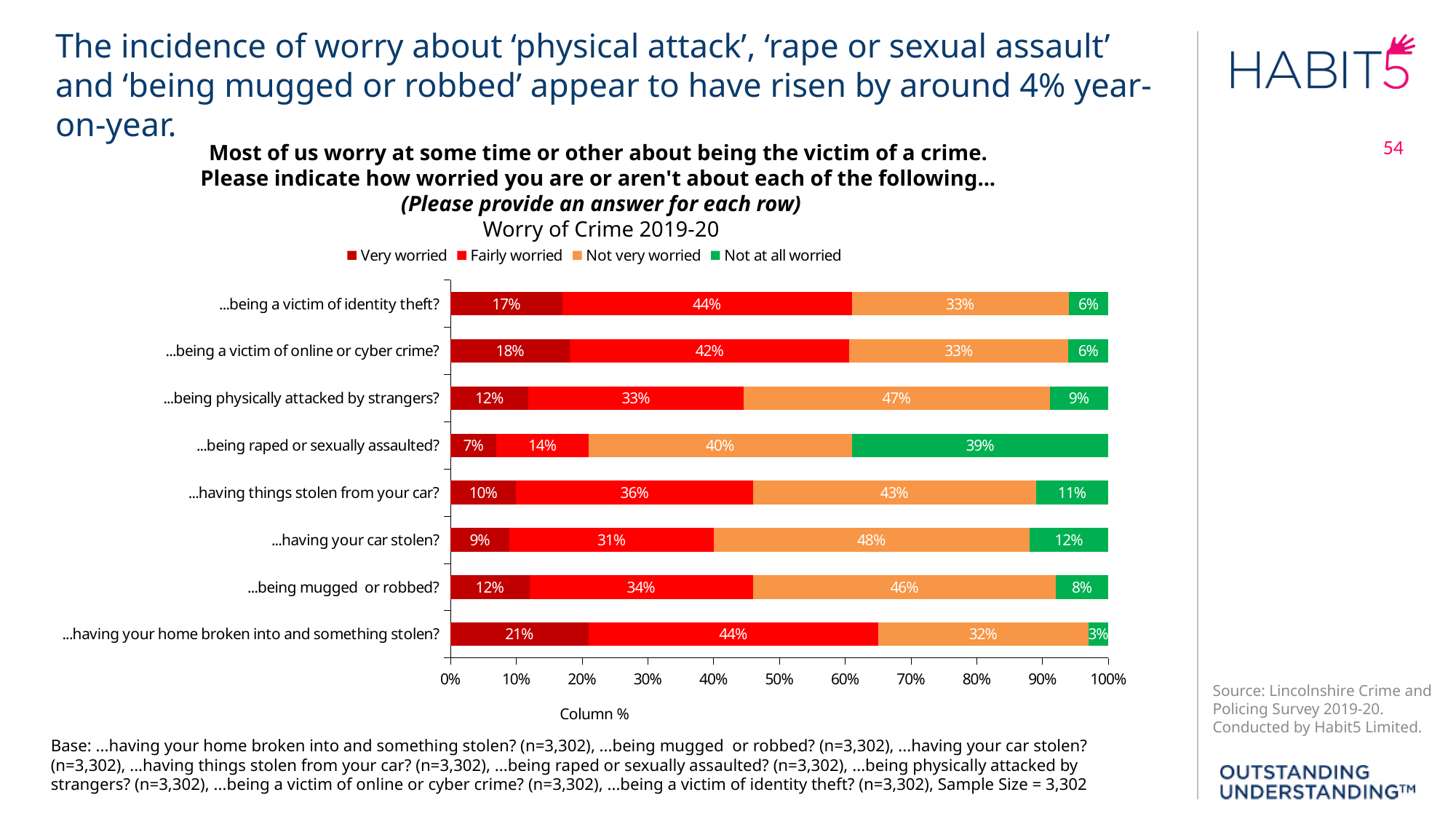
What is the difference between the 'Fairly worried' percentages for being a victim of identity theft and being a victim of online or cyber crime? 2% What percentage of respondents are 'Not very worried' about having their car stolen? 48% What kind of chart is shown on the slide? Stacked bar chart Which category has the highest 'Very worried' percentage? ...having your home broken into and something stolen? What is the combined percentage of 'Very worried' and 'Fairly worried' respondents for being physically attacked by strangers? 45% How many categories (crime types) are shown on the chart? 8 What percentage of respondents are 'Very worried' about having their home broken into and something stolen? 21% Which is larger: the 'Not at all worried' percentage for having your car stolen or for being mugged or robbed? having your car stolen What percentage of respondents are 'Fairly worried' about being a victim of identity theft? 44% How many series does the legend list? 4 What percentage of respondents are 'Not at all worried' about being raped or sexually assaulted? 39% Which category has the lowest 'Very worried' percentage? ...being raped or sexually assaulted?